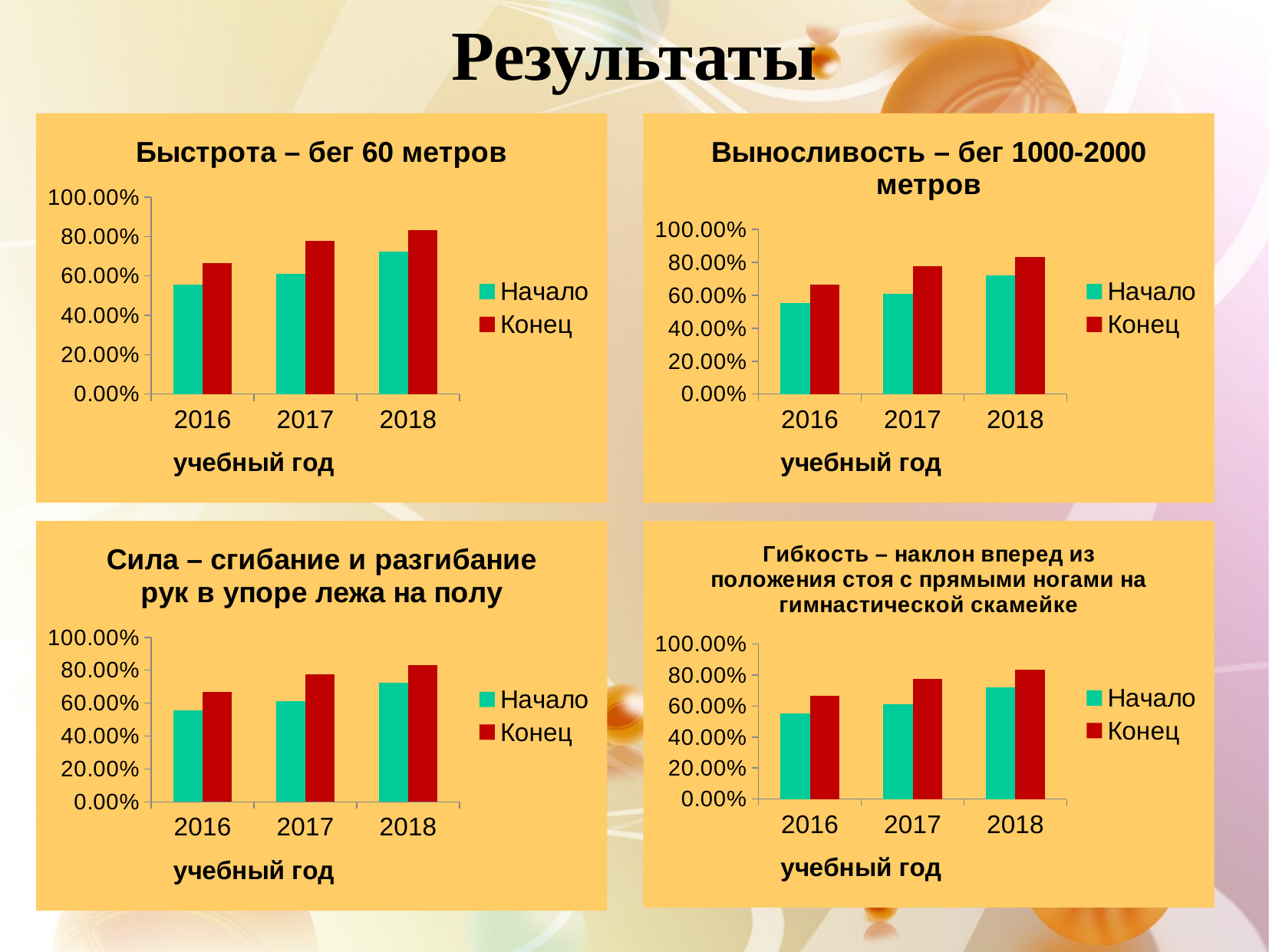
In the chart titled "Сила – сгибание и разгибание рук в упоре лежа на полу", which year has the lowest value for Начало? 2016 In the chart titled "Выносливость – бег 1000-2000 метров", how many years are shown on the x axis? 3 In the bottom-right chart, do the values for Начало rise or fall from 2016 to 2018? rise In the bottom-right chart, is the value for Начало in 2018 greater or less than 60.00%? greater In the chart titled "Быстрота – бег 60 метров", which series is shown in red? Конец In the chart titled "Быстрота – бег 60 метров", what kind of chart is shown? bar chart In the chart titled "Быстрота – бег 60 метров", is the value for Начало in 2016 greater or less than 60.00%? less In the chart titled "Выносливость – бег 1000-2000 метров", which year has the highest value for Конец? 2018 In the chart titled "Сила – сгибание и разгибание рук в упоре лежа на полу", what is the label of the x axis? учебный год In the chart titled "Быстрота – бег 60 метров", how many series does the legend list? 2 In the chart titled "Сила – сгибание и разгибание рук в упоре лежа на полу", which is larger in 2016, Начало or Конец? Конец In the chart titled "Выносливость – бег 1000-2000 метров", is the value for Конец in 2017 greater or less than 60.00%? greater